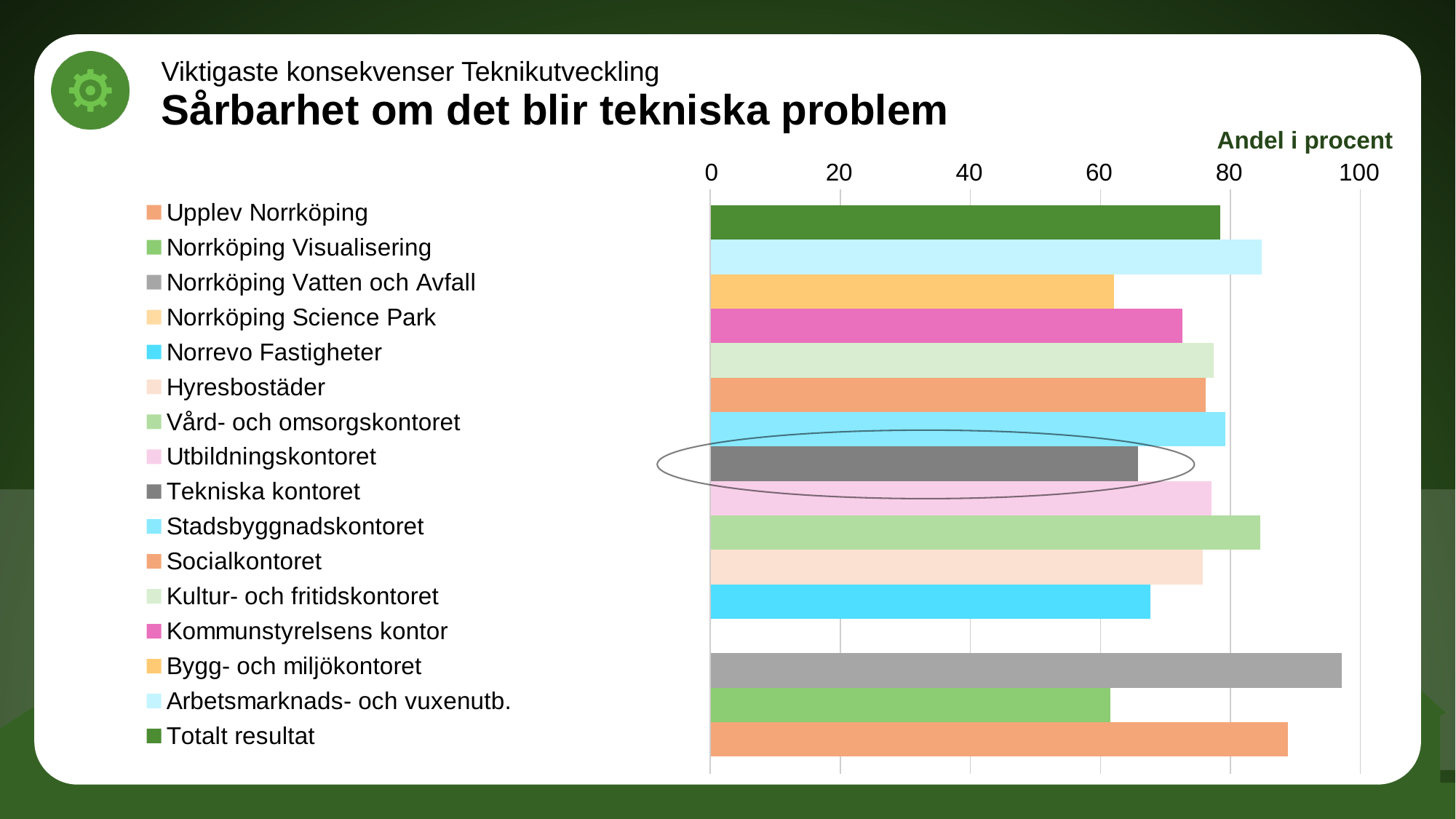
Which category's bar is circled in the chart? Tekniska kontoret Is the value for Upplev Norrköping greater or less than 80? greater Which category has the highest value in the chart? Norrköping Vatten och Avfall Which is larger, the value for Upplev Norrköping or the value for Tekniska kontoret? Upplev Norrköping What is the label shown above the horizontal axis of the chart? Andel i procent How many categories does the legend list? 16 Which is larger, the value for Norrköping Vatten och Avfall or the value for Norrköping Visualisering? Norrköping Vatten och Avfall What kind of chart is shown on the slide? bar chart Is the value for Norrköping Vatten och Avfall greater or less than 80? greater Is the value for Tekniska kontoret greater or less than 80? less